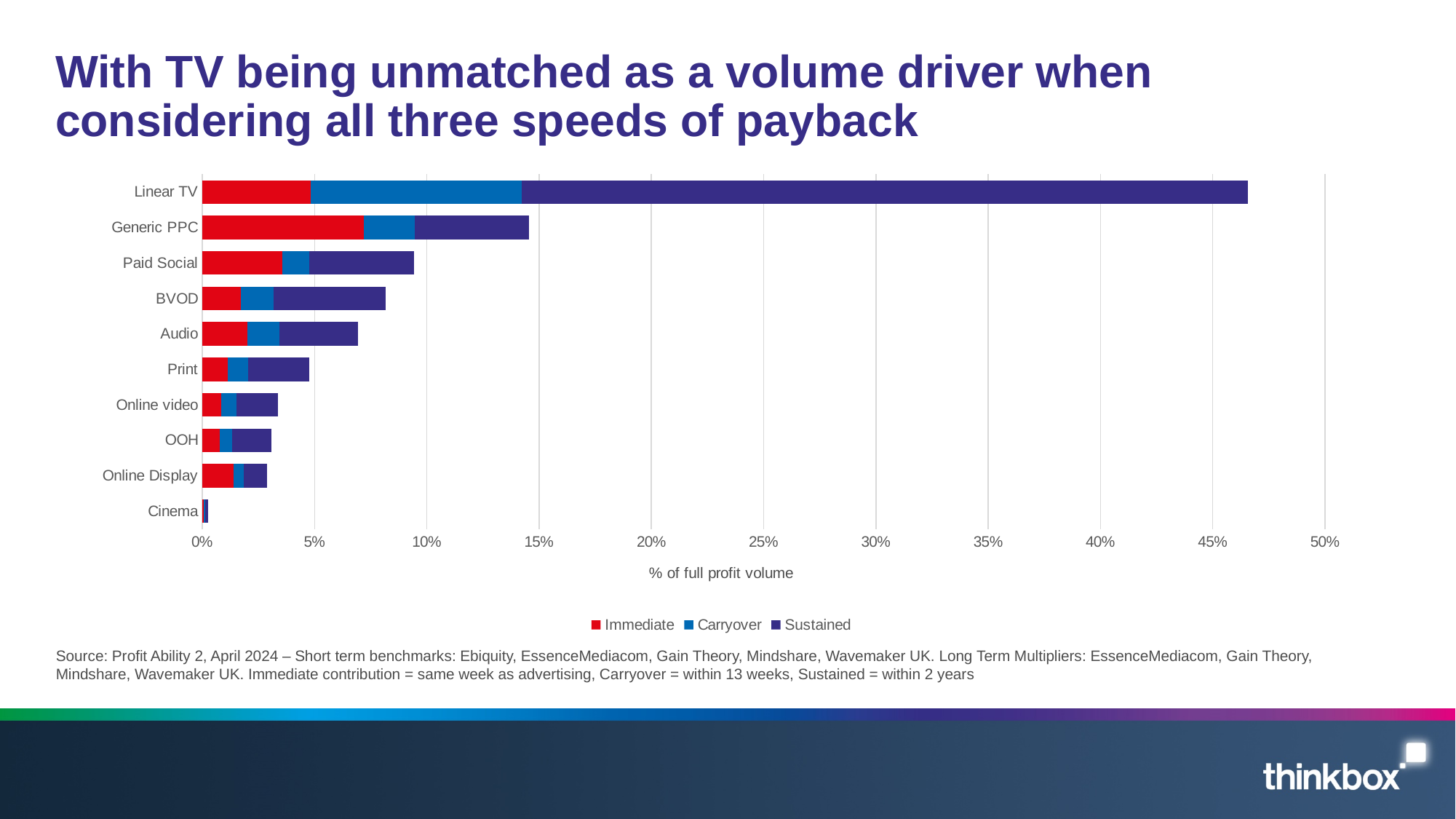
Which colour represents the Immediate series in the legend? Red What is the title of the horizontal axis? % of full profit volume Is the total value for Linear TV greater or less than 45%? greater How many media channels (categories) are plotted on the chart? 10 Which has the larger total % of full profit volume, Generic PPC or Paid Social? Generic PPC What kind of chart is shown on the slide? Stacked bar chart Is the total value for BVOD greater or less than 5%? greater Which channel has the highest total % of full profit volume? Linear TV Which channel has the lowest total % of full profit volume? Cinema Is the total value for Cinema greater or less than 5%? less How many series does the legend list? 3